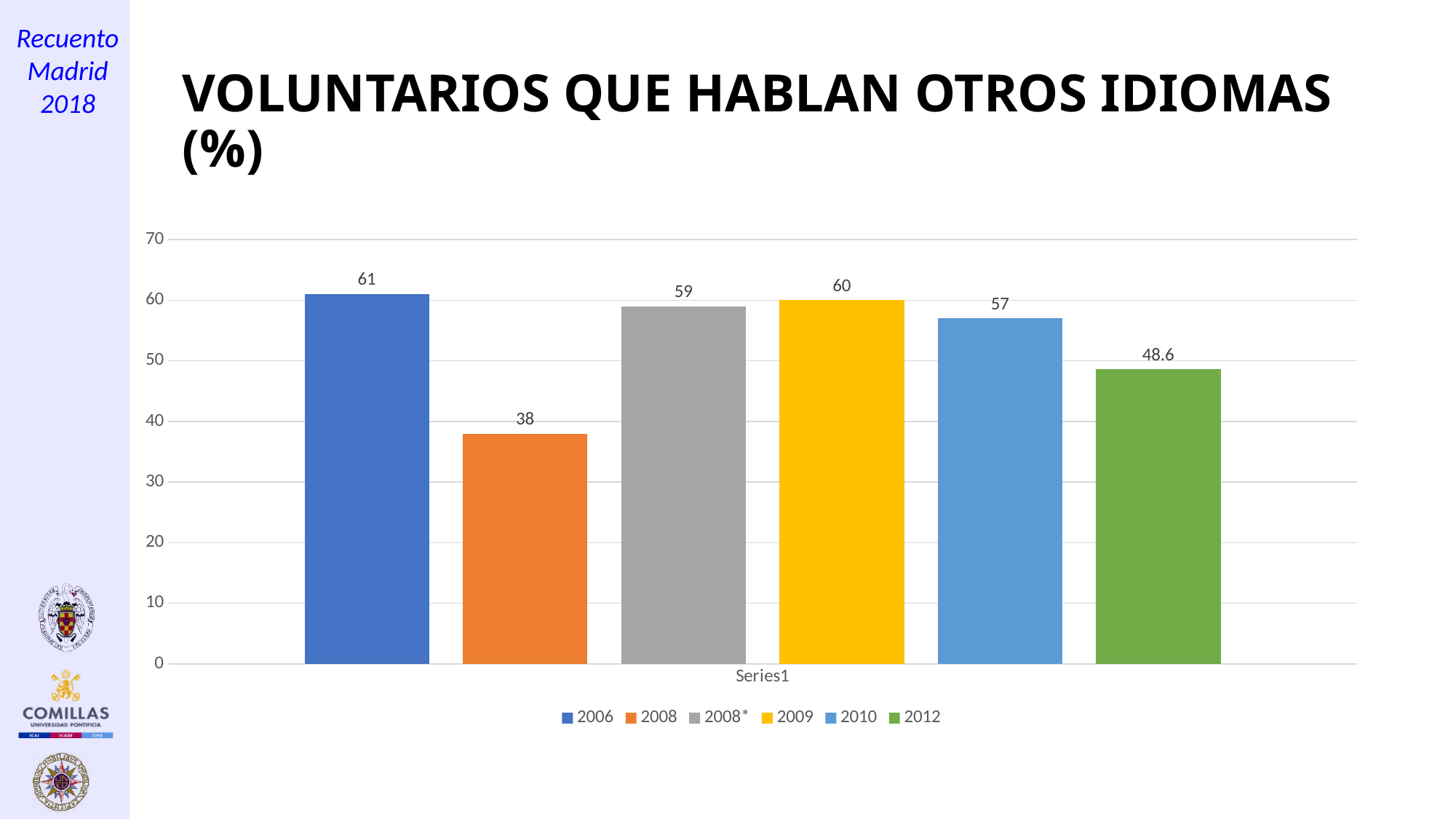
What is the value for 2012? 48.6 What is the title of the chart? VOLUNTARIOS QUE HABLAN OTROS IDIOMAS (%) What is the difference between the values for 2009 and 2010? 3 Is the value for 2008 greater or less than 40? less What is the value for 2008*? 59 What kind of chart is shown on the slide? bar chart Which legend entry has the highest value? 2006 How many series does the legend list? 6 Which legend entry has the lowest value? 2008 What is the value for 2006? 61 Which is larger, the value for 2010 or the value for 2012? 2010 What is the difference between the values for 2006 and 2008? 23